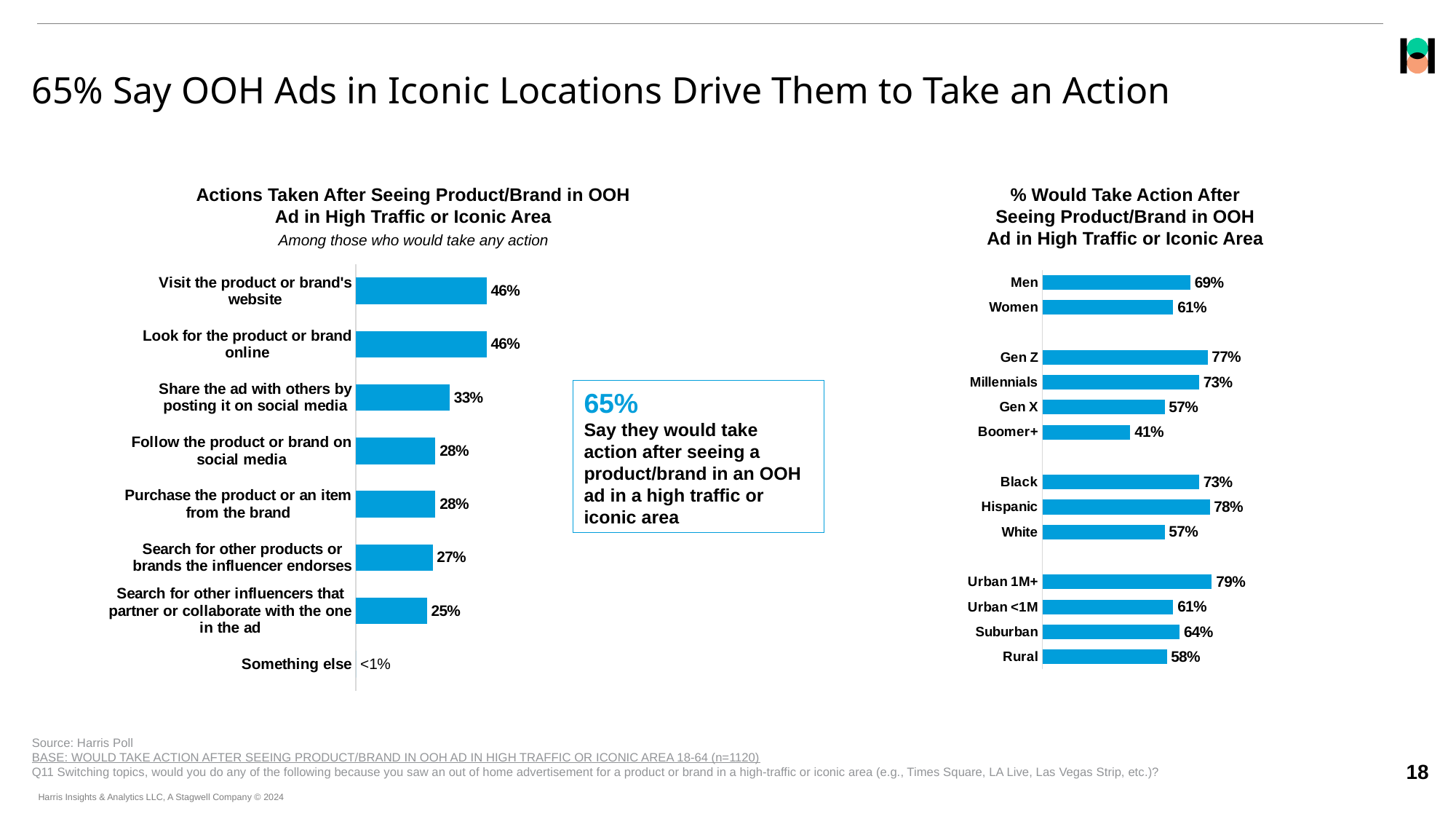
In the '% Would Take Action After Seeing Product/Brand in OOH Ad in High Traffic or Iconic Area' chart, how many groups are shown? 13 In the 'Actions Taken After Seeing Product/Brand in OOH Ad in High Traffic or Iconic Area' chart, what is the difference between 'Look for the product or brand online' and 'Follow the product or brand on social media'? 18 percentage points In the '% Would Take Action After Seeing Product/Brand in OOH Ad in High Traffic or Iconic Area' chart, what percentage of Millennials would take action? 73% In the '% Would Take Action After Seeing Product/Brand in OOH Ad in High Traffic or Iconic Area' chart, which is larger, Hispanic or White? Hispanic In the '% Would Take Action After Seeing Product/Brand in OOH Ad in High Traffic or Iconic Area' chart, which group has the highest value? Urban 1M+ In the 'Actions Taken After Seeing Product/Brand in OOH Ad in High Traffic or Iconic Area' chart, what percentage would share the ad with others by posting it on social media? 33% In the 'Actions Taken After Seeing Product/Brand in OOH Ad in High Traffic or Iconic Area' chart, how many action categories are listed? 8 In the 'Actions Taken After Seeing Product/Brand in OOH Ad in High Traffic or Iconic Area' chart, what value is shown for 'Something else'? <1% In the 'Actions Taken After Seeing Product/Brand in OOH Ad in High Traffic or Iconic Area' chart, what percentage would search for other influencers that partner or collaborate with the one in the ad? 25% In the '% Would Take Action After Seeing Product/Brand in OOH Ad in High Traffic or Iconic Area' chart, what is the difference between Men and Women? 8 percentage points In the '% Would Take Action After Seeing Product/Brand in OOH Ad in High Traffic or Iconic Area' chart, which group has the lowest value? Boomer+ What type of chart is the '% Would Take Action After Seeing Product/Brand in OOH Ad in High Traffic or Iconic Area' chart? Bar chart